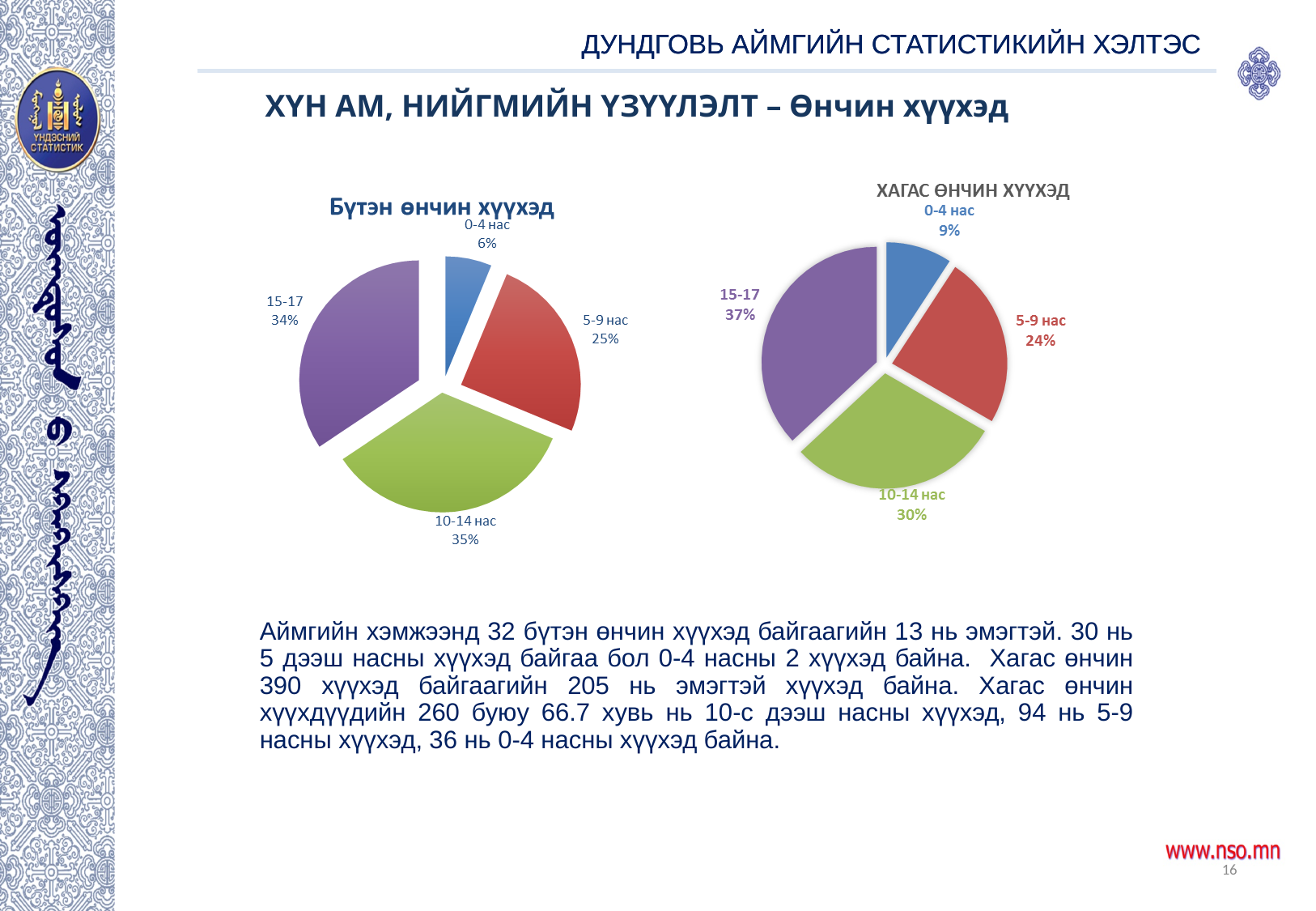
In the "Бүтэн өнчин хүүхэд" chart, what share does the 10-14 нас slice have? 35% Which is larger in the "Бүтэн өнчин хүүхэд" chart: the 15-17 slice or the 5-9 нас slice? 15-17 In the "Бүтэн өнчин хүүхэд" chart, what share does the 0-4 нас slice have? 6% In the "ХАГАС ӨНЧИН ХҮҮХЭД" chart, what share does the 5-9 нас slice have? 24% In the "ХАГАС ӨНЧИН ХҮҮХЭД" chart, what share does the 15-17 slice have? 37% In the "ХАГАС ӨНЧИН ХҮҮХЭД" chart, which age group has the smallest share? 0-4 нас How many slices does the "ХАГАС ӨНЧИН ХҮҮХЭД" chart have? 4 In the "Бүтэн өнчин хүүхэд" chart, what is the difference in percentage points between the 5-9 нас and 0-4 нас slices? 19 In the "Бүтэн өнчин хүүхэд" chart, which age group has the largest share? 10-14 нас What type of chart is the "Бүтэн өнчин хүүхэд" chart? Pie chart In the "ХАГАС ӨНЧИН ХҮҮХЭД" chart, what is the difference in percentage points between the 15-17 and 10-14 нас slices? 7 In the "ХАГАС ӨНЧИН ХҮҮХЭД" chart, which age group has the largest share? 15-17